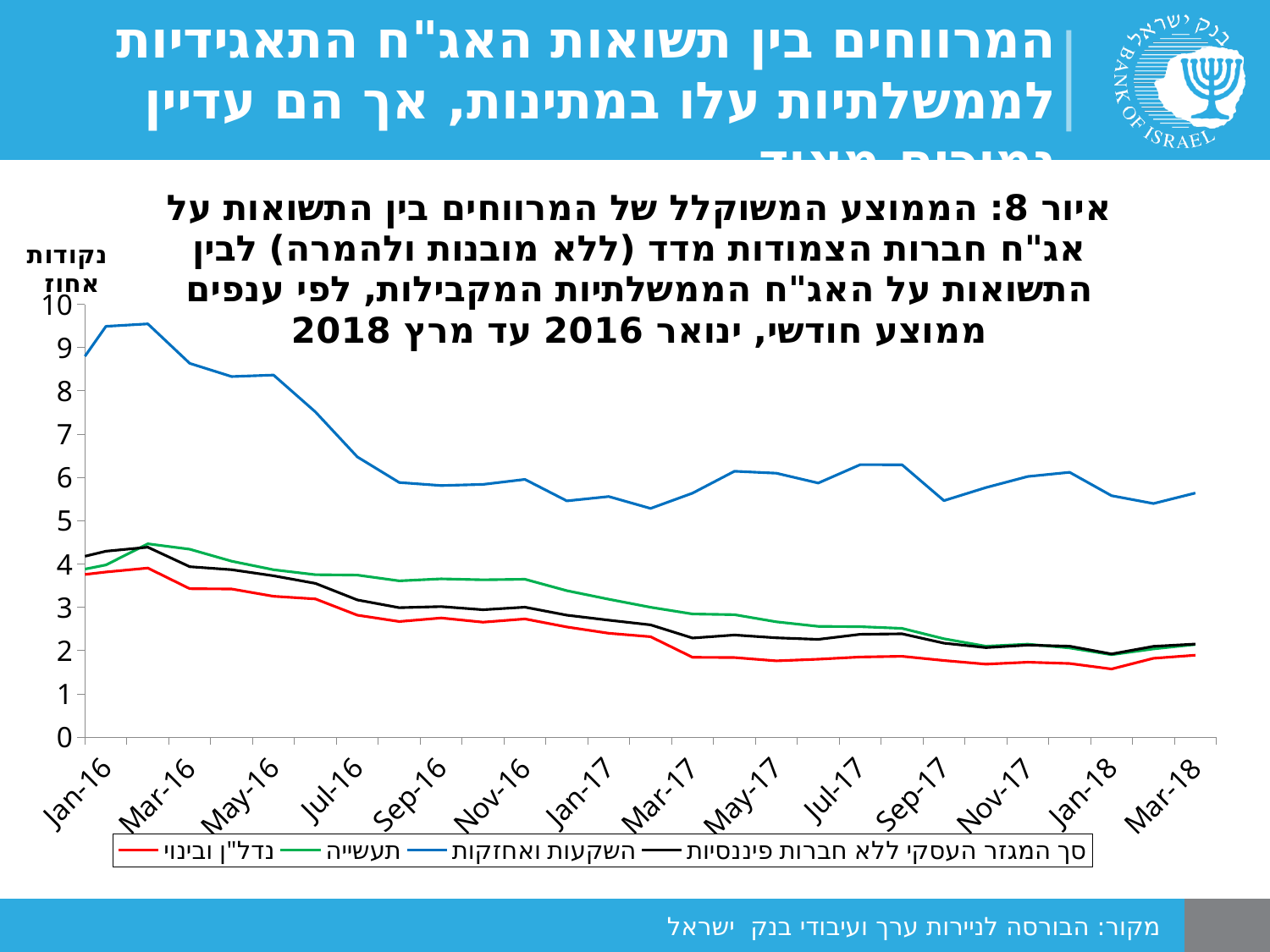
What unit label is shown at the top of the y axis? נקודות אחוז Is the value for נדל"ן ובינוי at Mar-18 greater or less than 3? less How many date labels are shown on the x axis? 14 Do the values for השקעות ואחזקות rise or fall from Jan-16 to Mar-18? fall What kind of chart is shown on the slide? line chart Which is larger at Jan-16: the value for השקעות ואחזקות or the value for נדל"ן ובינוי? השקעות ואחזקות Is the value for השקעות ואחזקות at Jan-16 greater or less than 8? greater Which series has the lowest value at Mar-17? נדל"ן ובינוי How many series does the legend list? 4 Is the value for תעשייה at Nov-16 greater or less than 3? greater Which series has the highest values across the whole period? השקעות ואחזקות